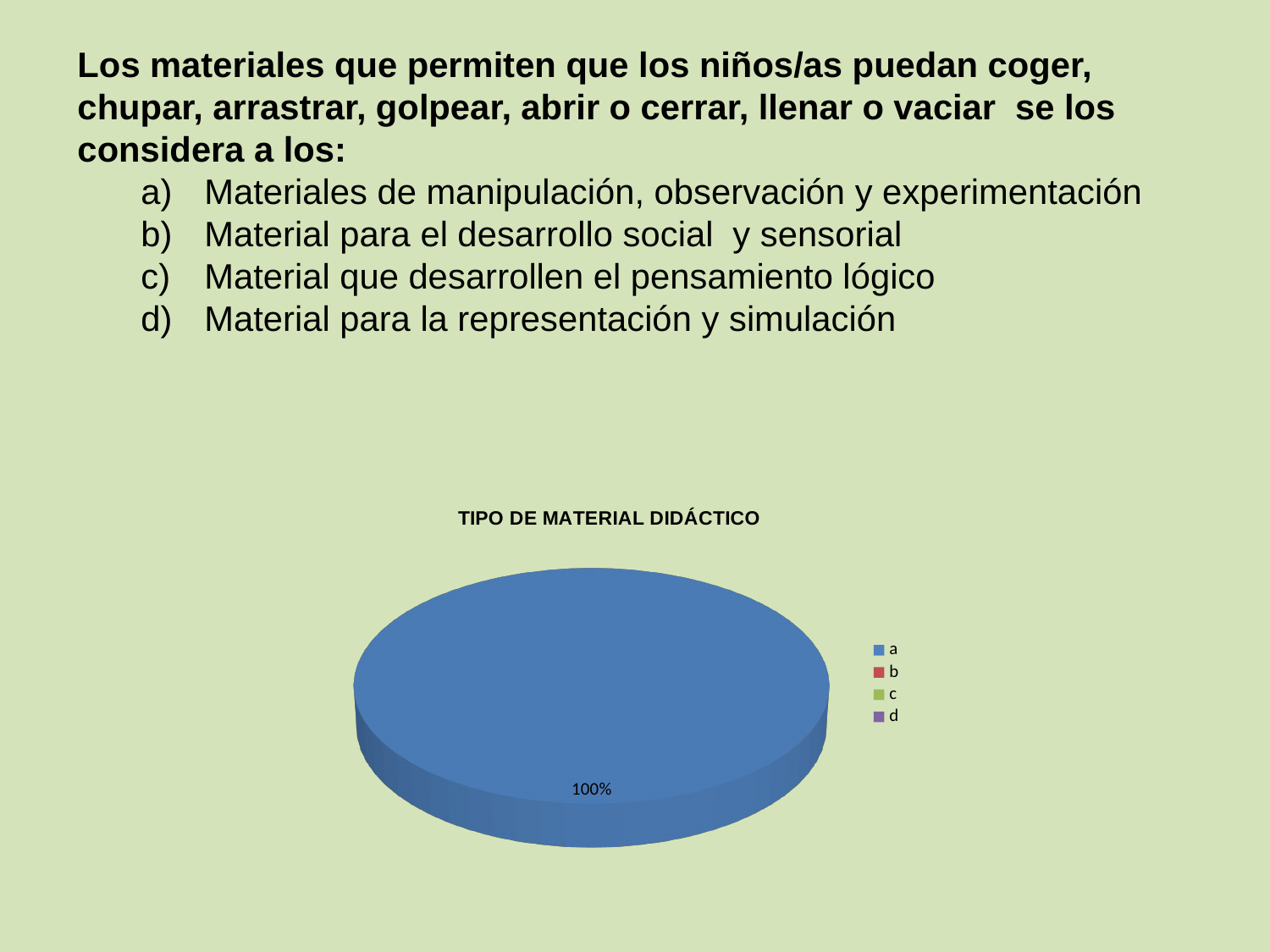
How many entries does the chart's legend list? 4 Which is larger, the share for category a or the share for category b? a Which legend entry is shown in blue? a What is the title of the chart? TIPO DE MATERIAL DIDÁCTICO What share of the pie does category a hold? 100% What kind of chart is shown on the slide? pie chart Which category has the largest share of the pie? a What percentage label is printed on the pie? 100% Is the share for category a greater or less than 50%? greater